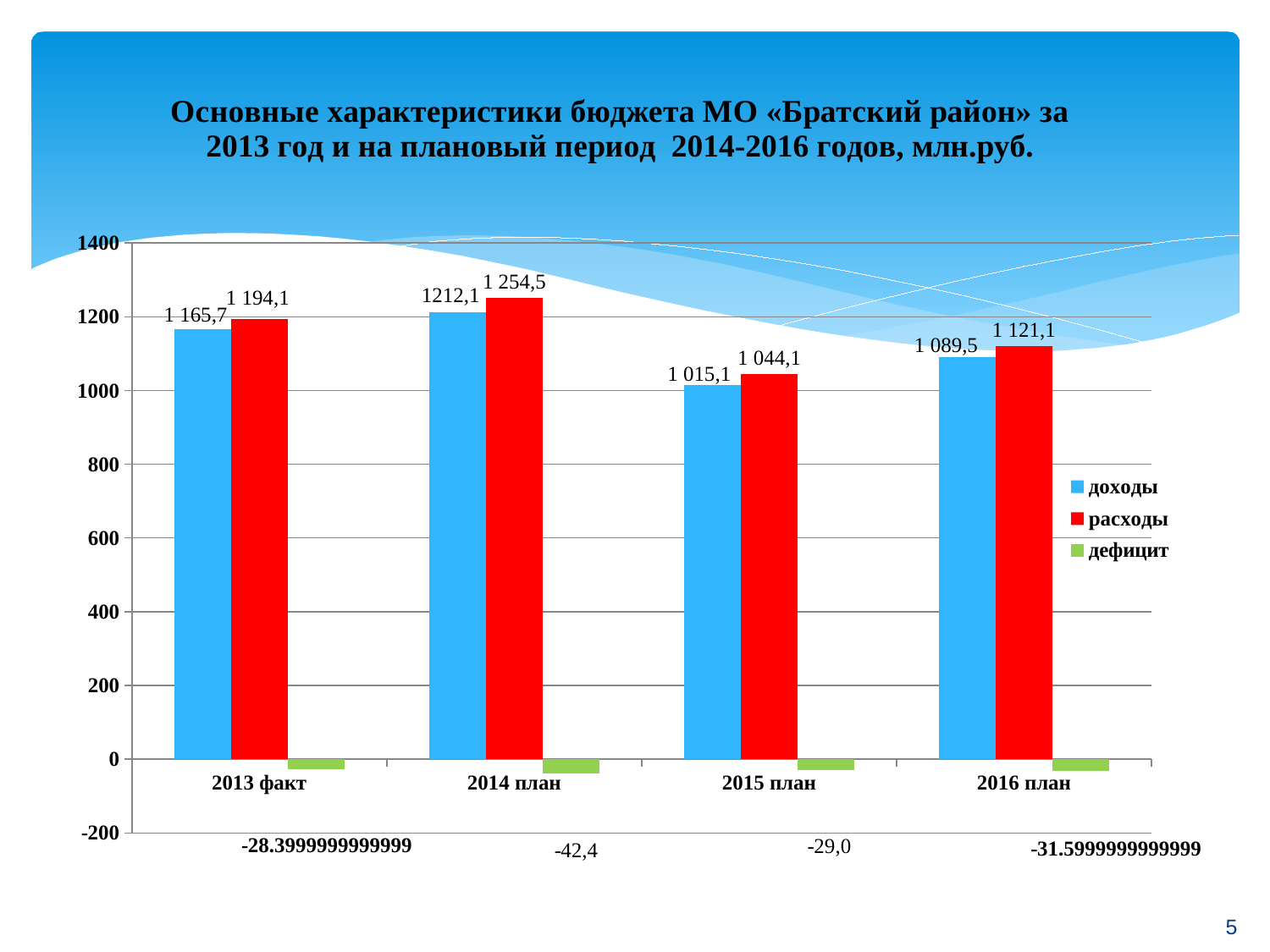
What is the value of дефицит for 2015 план? -29,0 How many categories are shown on the x axis? 4 What is the value of доходы for 2013 факт? 1 165,7 In which category is расходы the highest? 2014 план What is the value of доходы for 2016 план? 1 089,5 What is the difference between расходы and доходы for 2015 план? 29,0 What is the value of расходы for 2014 план? 1 254,5 Is the value of доходы for 2015 план greater or less than 1000? greater What kind of chart is shown on the slide? bar chart How many series does the legend list? 3 In which category is доходы the lowest? 2015 план Which is larger for 2016 план, доходы or расходы? расходы